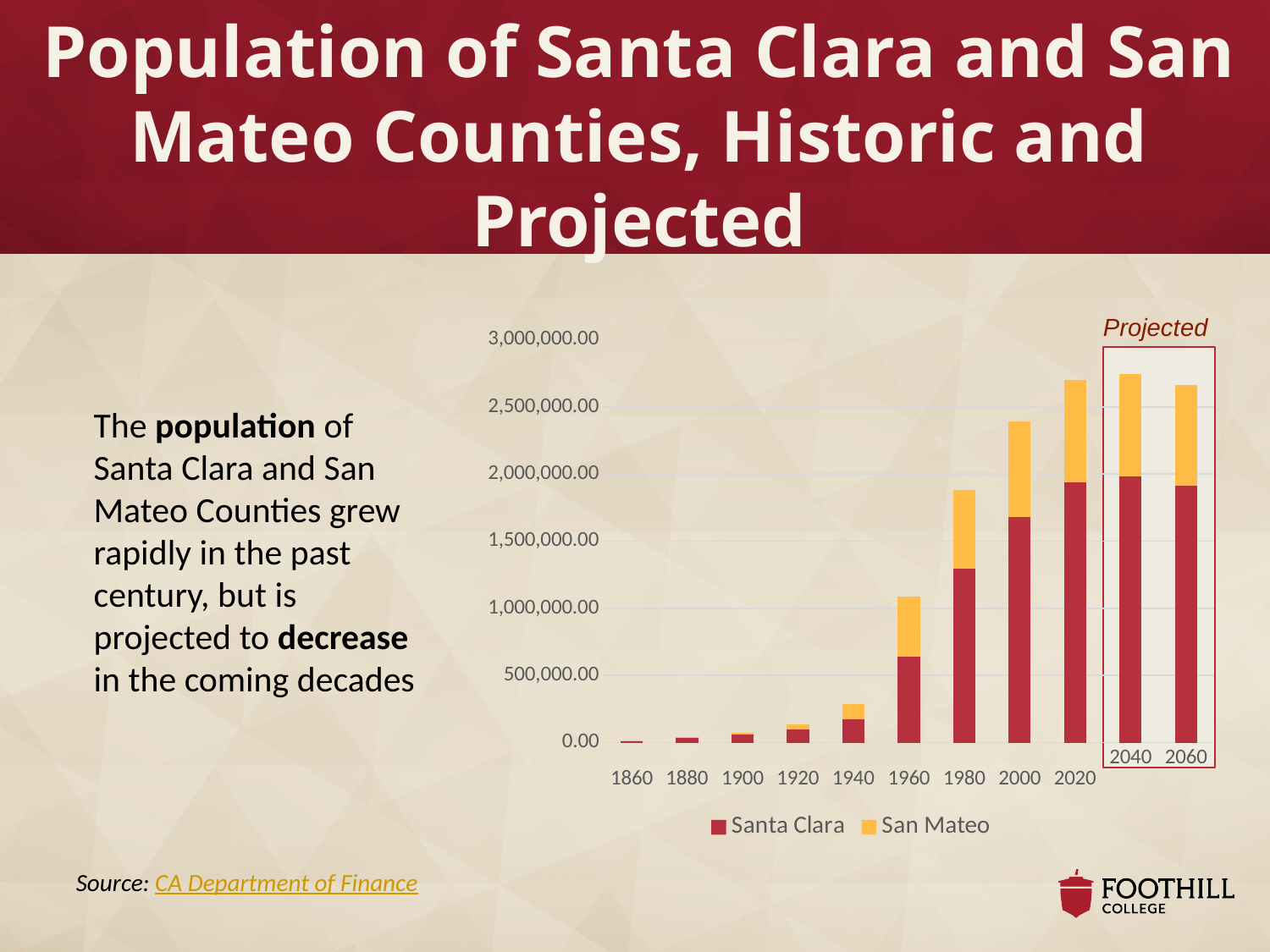
Do the total population bars rise or fall from 1860 to 2020? rise How many years (categories) are plotted along the x axis? 11 Which two years are enclosed in the box labelled 'Projected'? 2040 and 2060 Is the total population bar for 2020 greater or less than 2,500,000.00? greater Which year has the larger total population bar, 2040 or 2060? 2040 What kind of chart is shown on the slide? Stacked bar chart How many series does the legend list? 2 Which year has the lowest total population bar? 1860 Is the Santa Clara value for 2000 greater or less than 1,500,000.00? greater Is the total population bar for 2000 greater or less than 2,500,000.00? less Which year has the highest total population bar? 2040